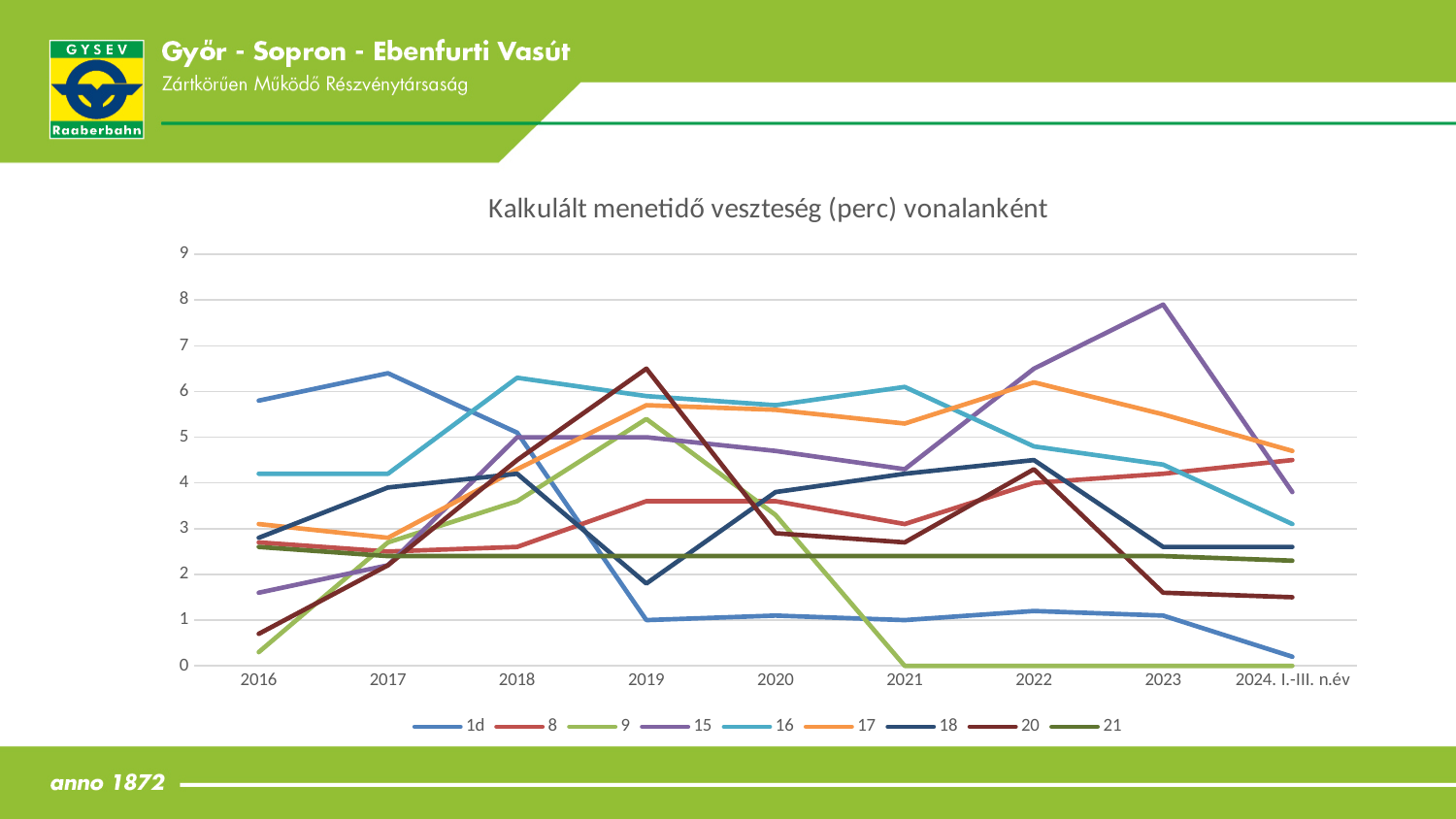
Which series has the lowest value in 2023? 9 Does the value for series 1d rise or fall from 2022 to 2024. I.-III. n.év? fall How many points are there along the x axis? 9 Which series has the highest value in 2016? 1d What is the title of the chart? Kalkulált menetidő veszteség (perc) vonalanként How many series does the legend list? 9 Is the value for series 20 in 2019 greater or less than 6? greater Which series has the highest value in 2023? 15 What kind of chart is shown on the slide? line chart Is the value for series 15 in 2023 greater or less than 7? greater What is the value for series 9 in 2021? 0 In 2016, which is larger: the value for series 16 or series 17? 16